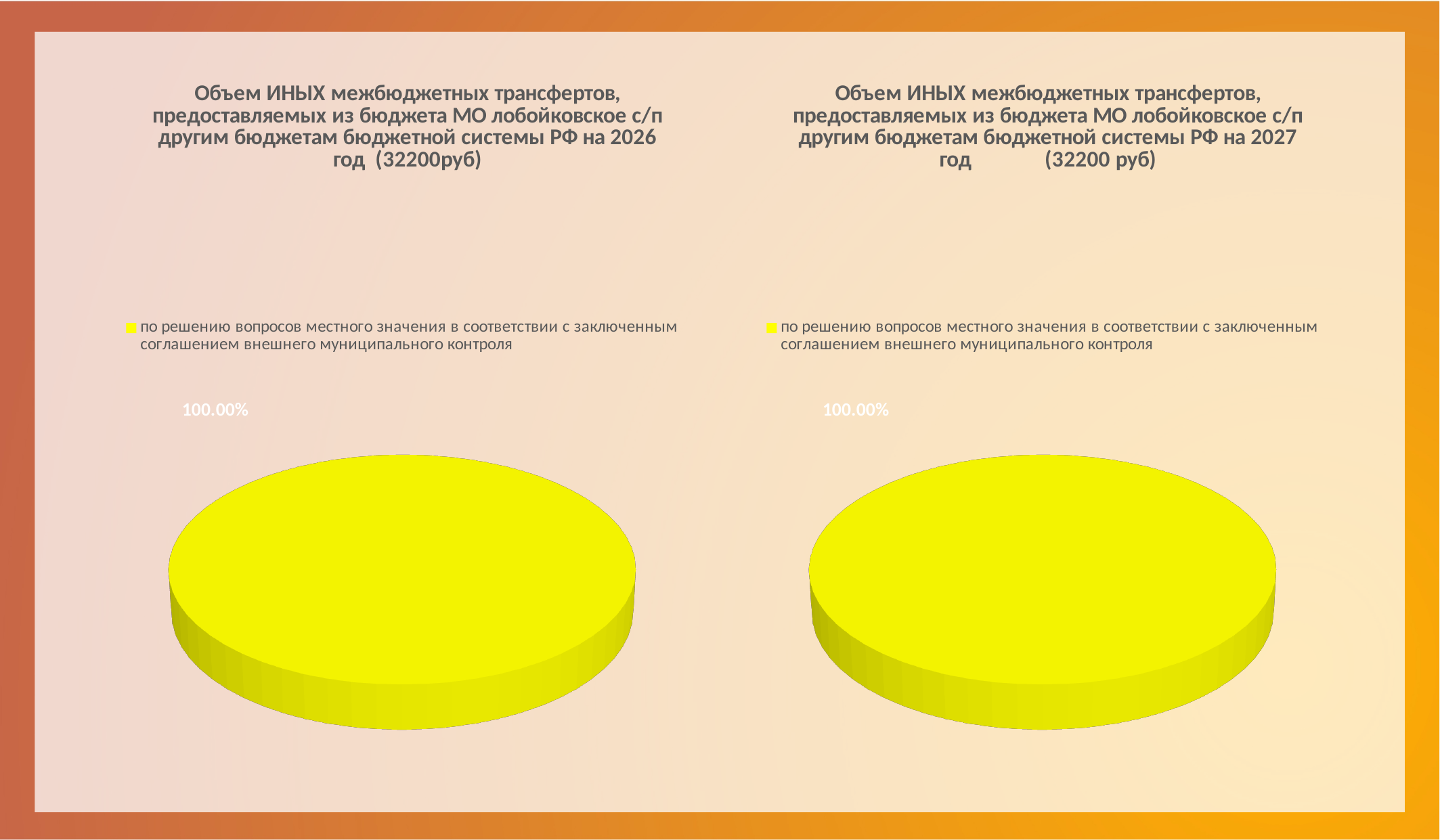
How many slices does the right chart (for 2027) have? 1 What kind of chart is the left chart (for 2026)? pie chart What total amount in rubles is stated in the title of the left chart (for 2026)? 32200руб How many entries does the legend of the right chart (for 2027) list? 1 In the left chart (for 2026), what share is shown for the slice 'по решению вопросов местного значения в соответствии с заключенным соглашением внешнего муниципального контроля'? 100.00% How many slices does the left chart (for 2026) have? 1 In the right chart (for 2027), what share is shown for the slice 'по решению вопросов местного значения в соответствии с заключенным соглашением внешнего муниципального контроля'? 100.00% How many entries does the legend of the left chart (for 2026) list? 1 What kind of chart is the right chart (for 2027)? pie chart What colour is the slice in the right chart (for 2027)? yellow